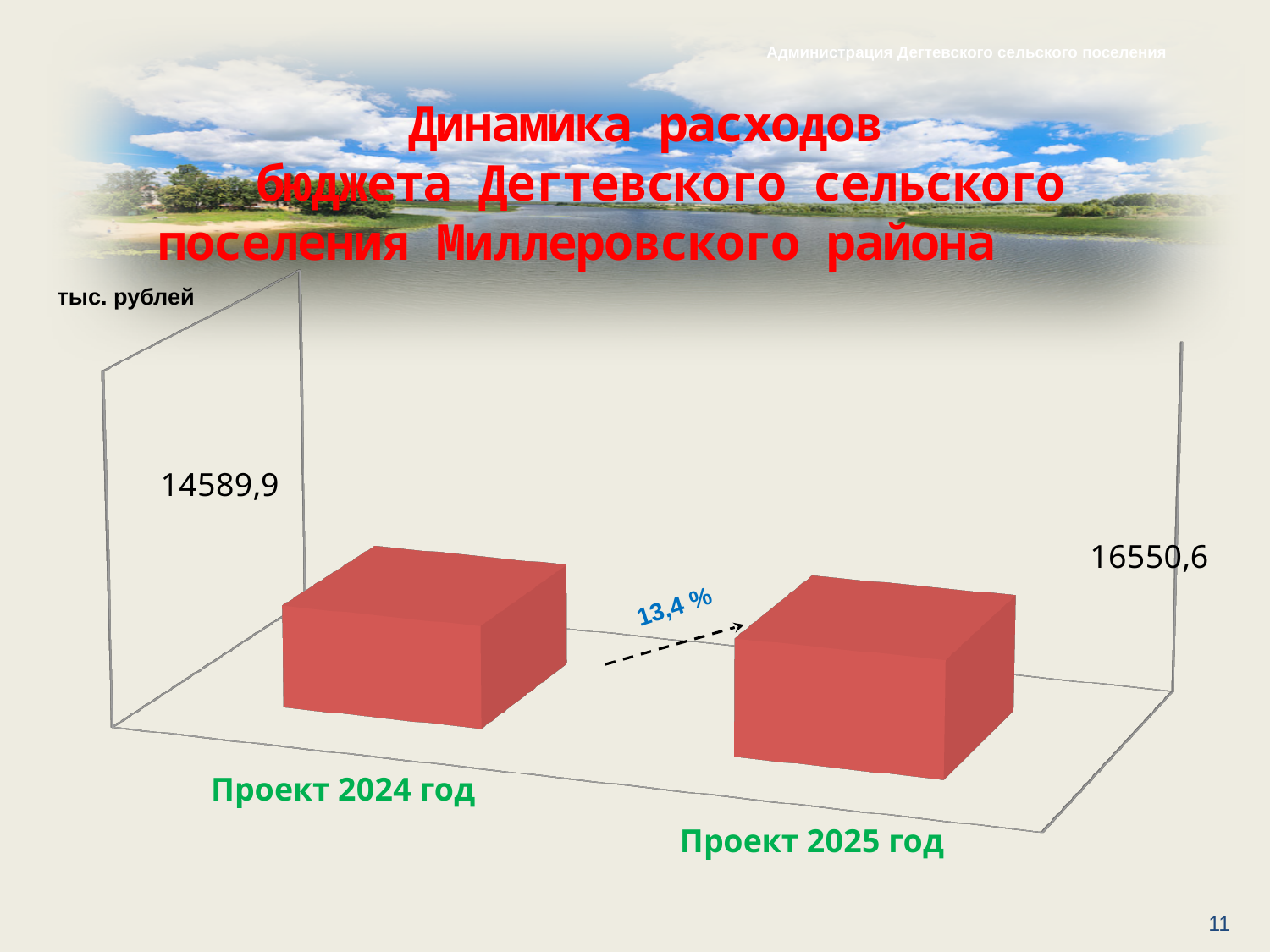
How many categories are shown in the chart? 2 Do the values rise or fall from Проект 2024 год to Проект 2025 год? Rise Which is larger, the value for Проект 2024 год or Проект 2025 год? Проект 2025 год What is the value for Проект 2025 год? 16550,6 What is the value for Проект 2024 год? 14589,9 What kind of chart is shown on the slide? Bar chart Which category has the lowest value? Проект 2024 год What unit of measurement is shown in the top-left corner of the chart? тыс. рублей Which category has the highest value? Проект 2025 год What percentage change is printed on the arrow between the two bars? 13,4 % What is the difference between the values for Проект 2025 год and Проект 2024 год? 1960,7